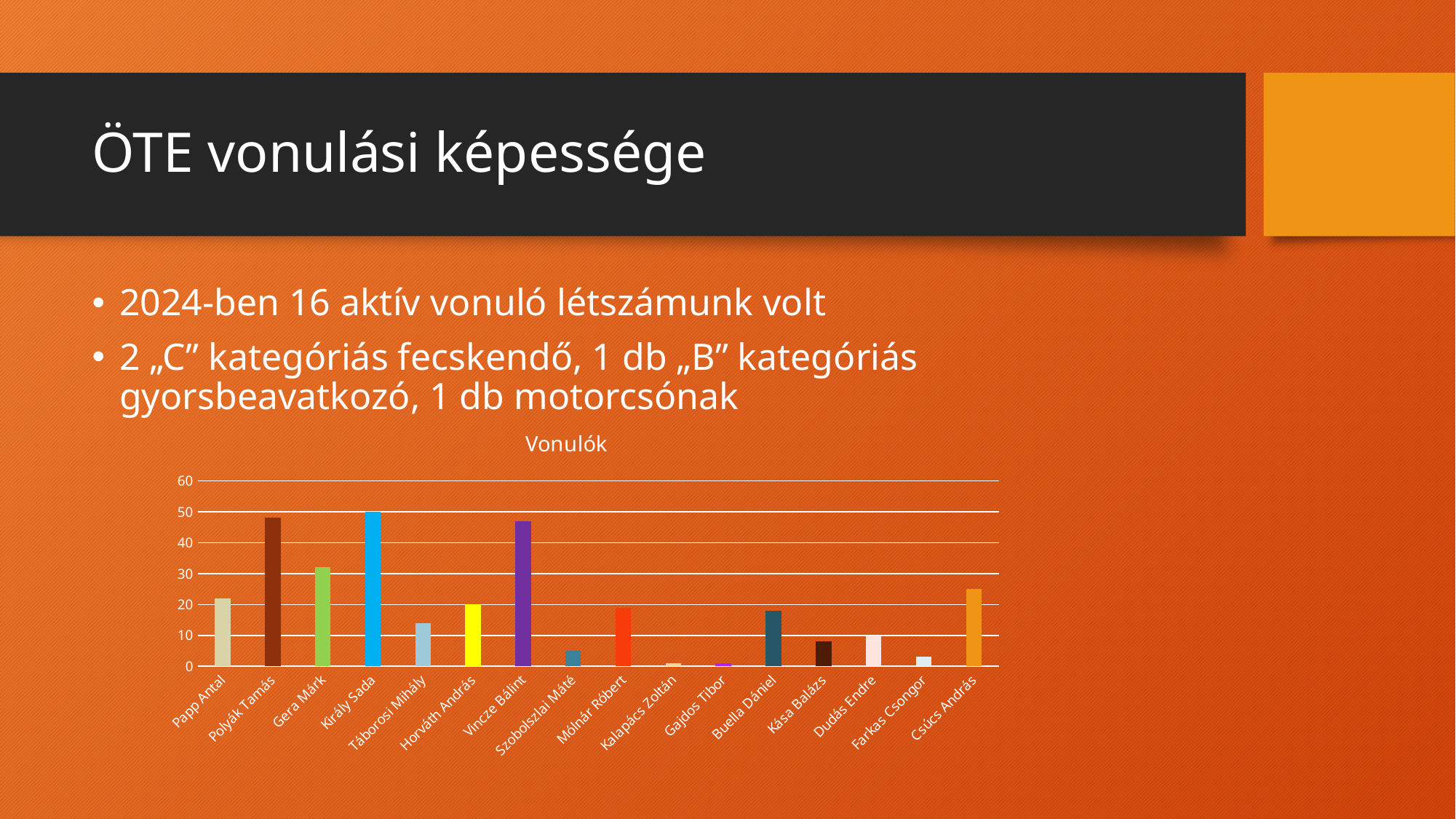
Is the value for Gera Márk greater or less than 30? greater Is the value for Szobolszlai Máté greater or less than 10? less Is the value for Polyák Tamás greater or less than 40? greater Which is larger, the value for Farkas Csongor or the value for Buella Dániel? Buella Dániel How many people (categories) are shown on the x axis of the chart? 16 Which is larger, the value for Gera Márk or the value for Papp Antal? Gera Márk What is the value for Király Sada? 50 What is the title of the chart? Vonulók What is the value for Horváth András? 20 What kind of chart is shown on the slide? bar chart